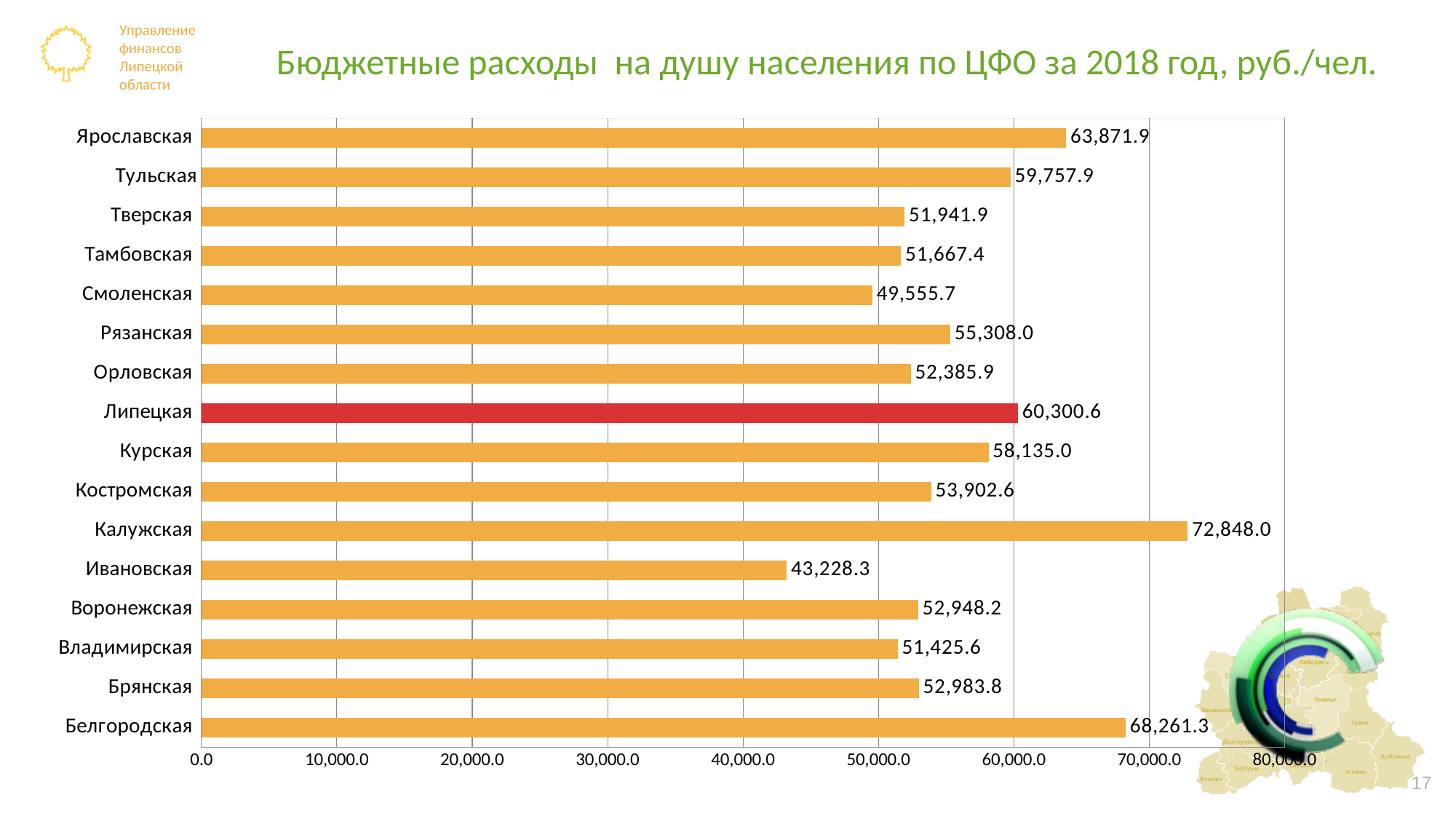
Which has a larger value, Курская or Рязанская? Курская What is the value for Липецкая? 60,300.6 Is the value for Ивановская greater or less than 50,000.0? less What is the difference between the values for Калужская and Липецкая? 12,547.4 Which region has the highest value? Калужская What is the value for Калужская? 72,848.0 What is the difference between the values for Белгородская and Ярославская? 4,389.4 How many regions are shown in the chart? 16 Which region's bar is coloured red instead of orange? Липецкая What kind of chart is shown on the slide? bar chart What is the value for Смоленская? 49,555.7 Which region has the lowest value? Ивановская